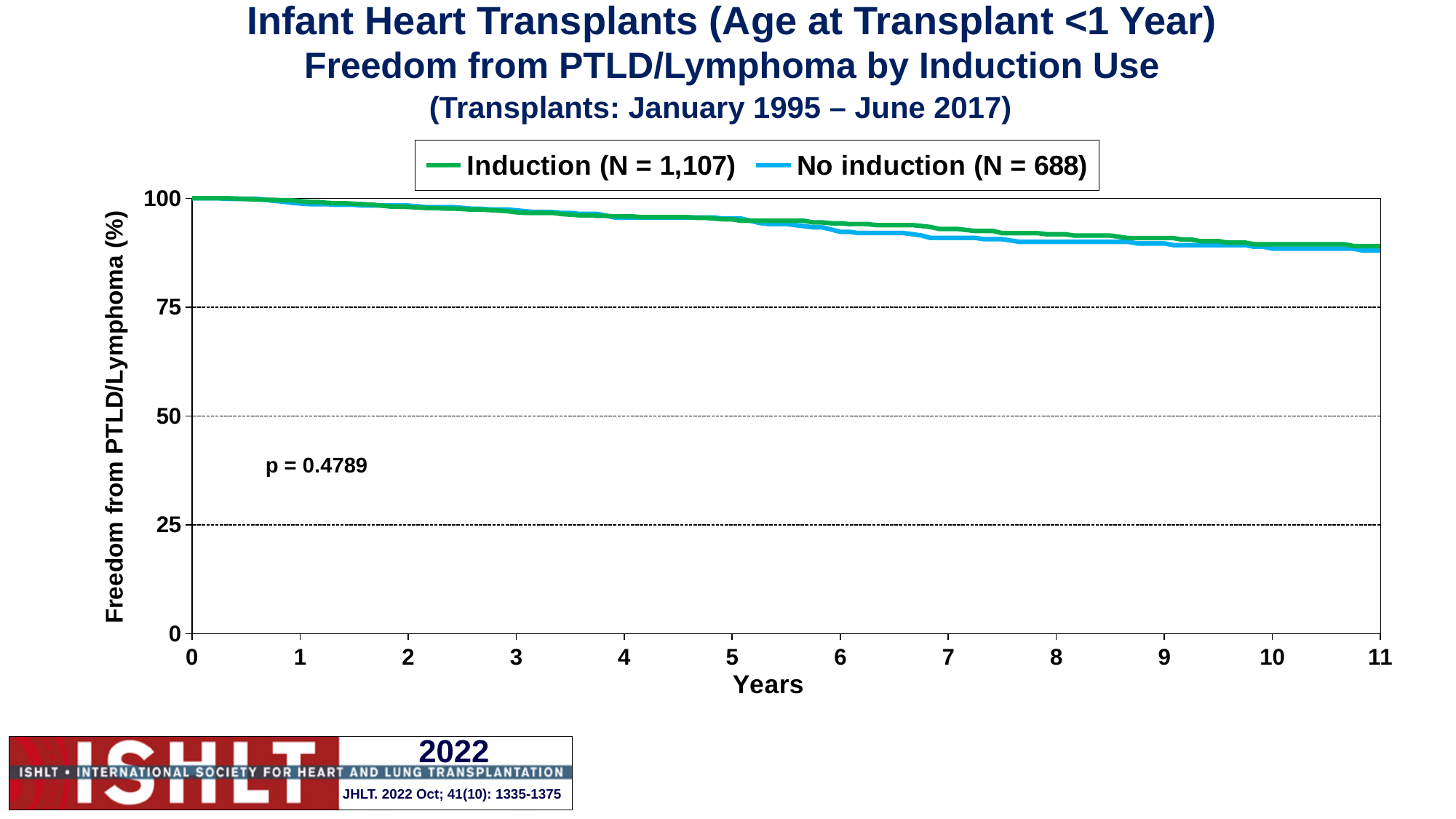
What is the N for the No induction group? 688 What is the N for the Induction group? 1,107 What kind of chart is shown on the slide? Line chart What is the freedom from PTLD/Lymphoma value for both curves at year 0? 100 At year 6, which curve is higher, Induction or No induction? Induction What is the label of the x axis? Years Is the value for the Induction curve at year 11 greater or less than 75? greater Is the value for the No induction curve at year 11 greater or less than 75? greater What p-value is printed on the chart? p = 0.4789 Do the curves rise or fall as years increase? Fall What are the two series named in the legend? Induction (N = 1,107) and No induction (N = 688) How many series does the legend list? 2